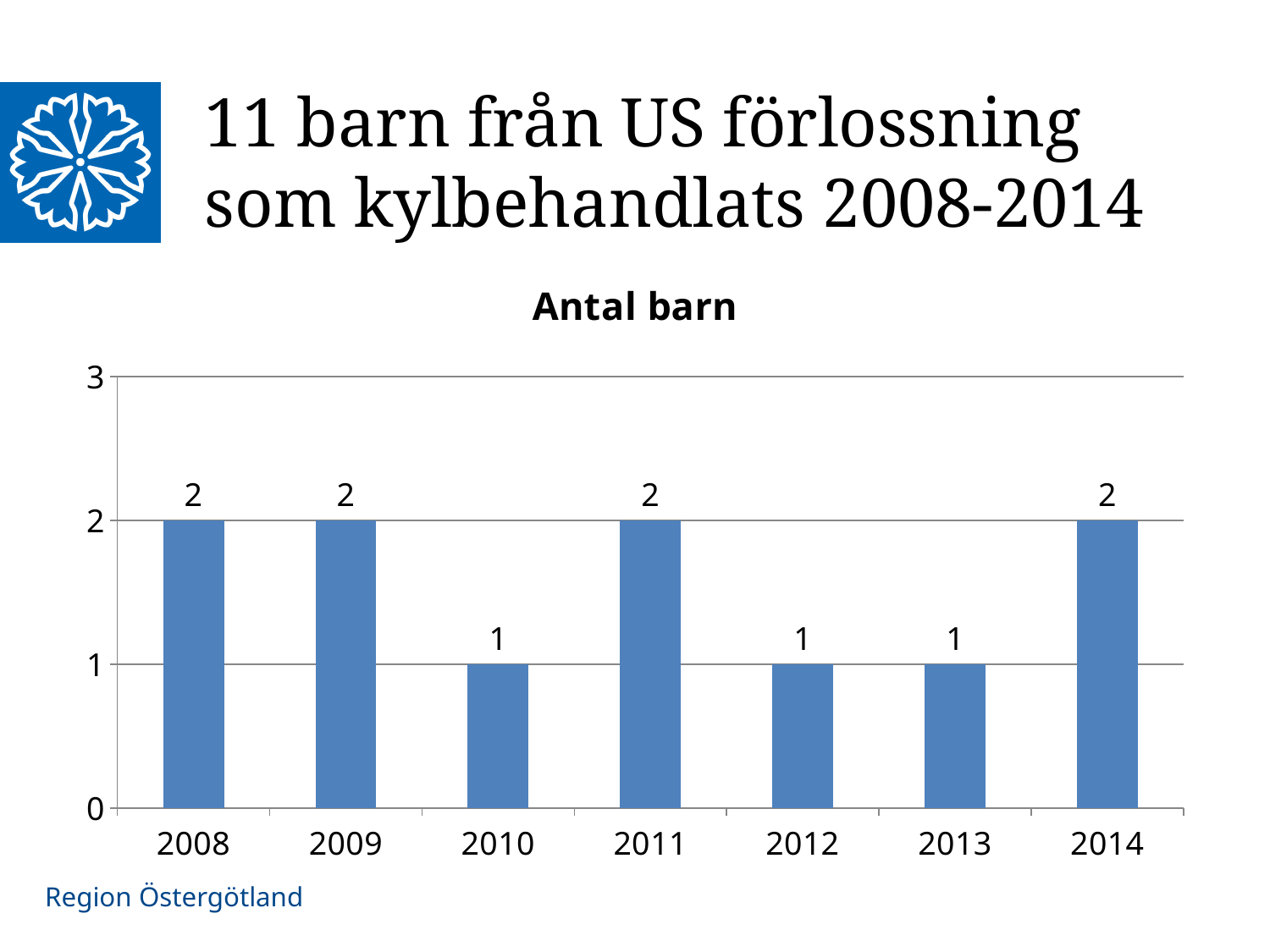
How many years are shown on the x axis? 7 What is the difference between the values for 2011 and 2012? 1 What is the value for 2012? 1 Which is larger, the value for 2009 or the value for 2010? 2009 What is the value for 2014? 2 What is the title of the chart? Antal barn Does the value rise or fall from 2013 to 2014? rise What is the highest value shown on the y axis? 3 Which years have the lowest value? 2010, 2012 and 2013 What kind of chart is this? bar chart What is the value for 2010? 1 What is the total of all the bars in the chart? 11